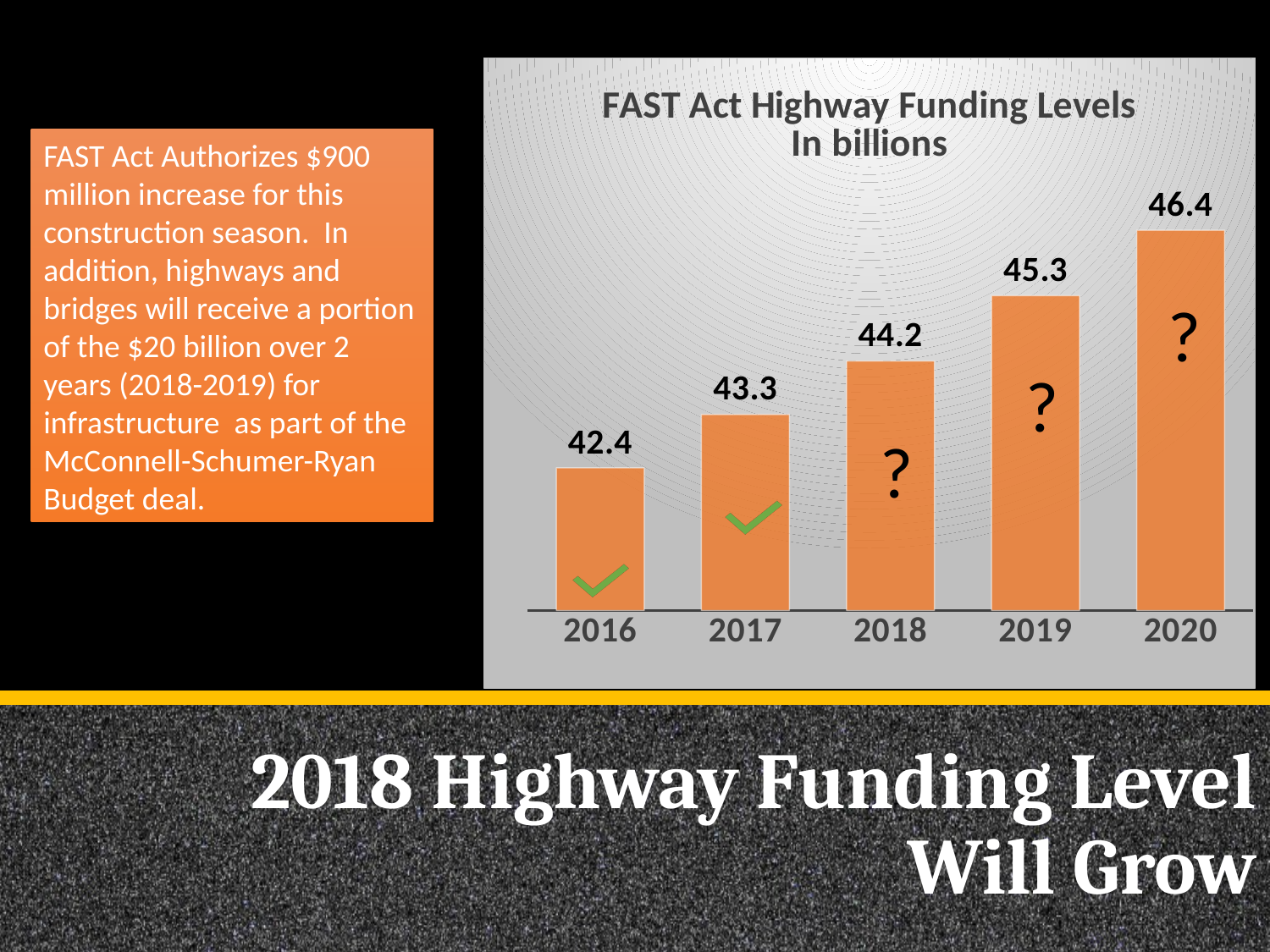
What is the FAST Act highway funding level for 2016? 42.4 What is the title of the chart? FAST Act Highway Funding Levels In billions Which year has the highest funding level in the chart? 2020 Which is larger, the funding level for 2017 or for 2019? 2019 What is the FAST Act highway funding level for 2018? 44.2 What is the FAST Act highway funding level for 2020? 46.4 What is the difference between the 2019 and 2018 funding levels? 1.1 Which year has the lowest funding level in the chart? 2016 What is the difference between the 2020 and 2016 funding levels? 4.0 What kind of chart is shown on the slide? Bar chart How many years are shown on the x axis of the chart? 5 Do the funding levels rise or fall from 2016 to 2020? Rise